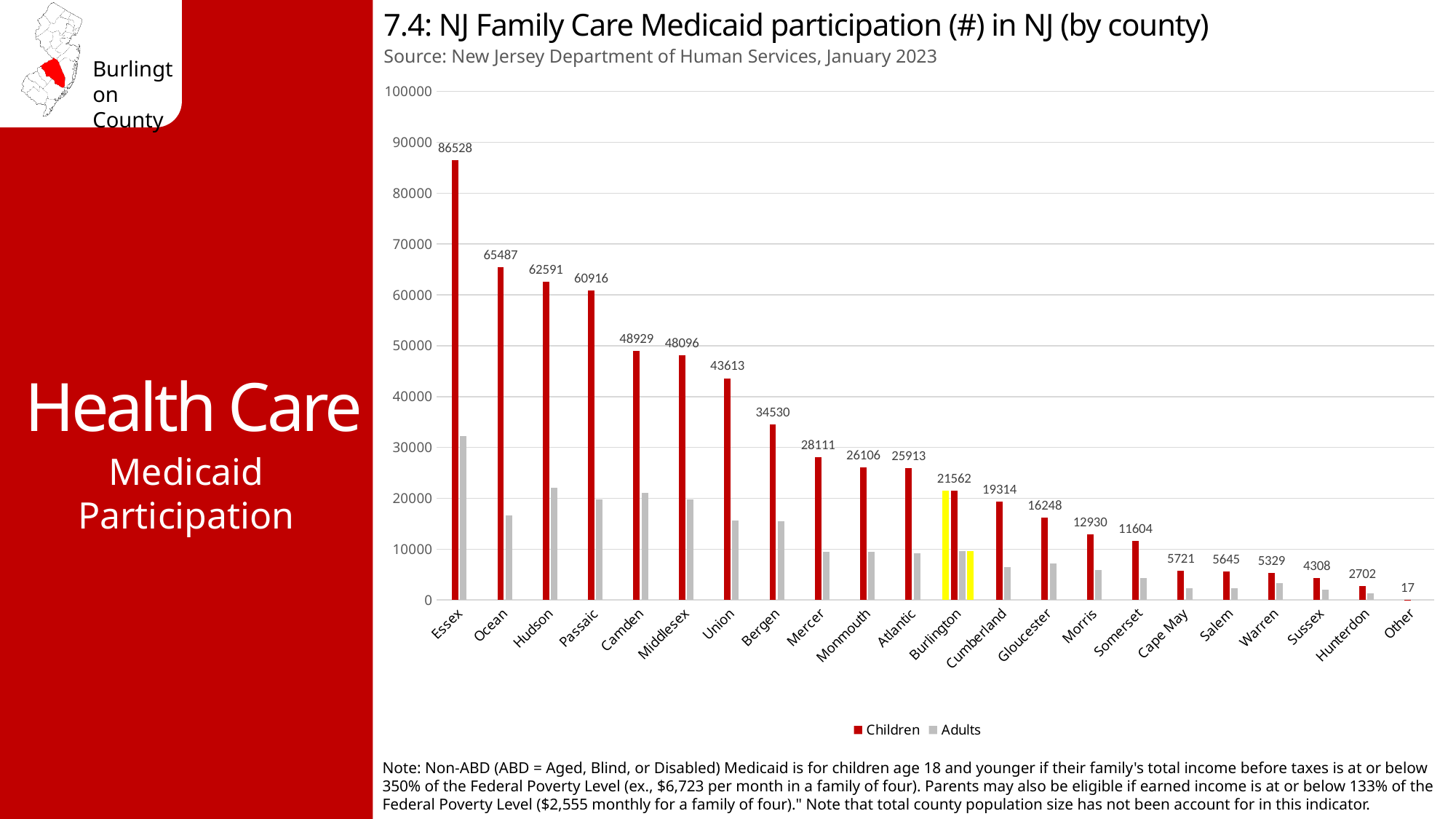
Which county has the lowest Children value among the named counties (excluding 'Other')? Hunterdon What is the Children value for Burlington County? 21562 What type of chart is shown on the slide? Bar chart What is the Children value for Hunterdon County? 2702 How many series does the legend list? 2 What is the number of children participating in NJ Family Care Medicaid in Essex County? 86528 How many categories are shown on the x axis? 22 What is the difference between the Children values for Ocean and Hudson counties? 2896 Is the Adults value for Essex County greater or less than 30000? greater Which county has a larger Children value, Camden or Union? Camden Which county has the highest number of children participating? Essex